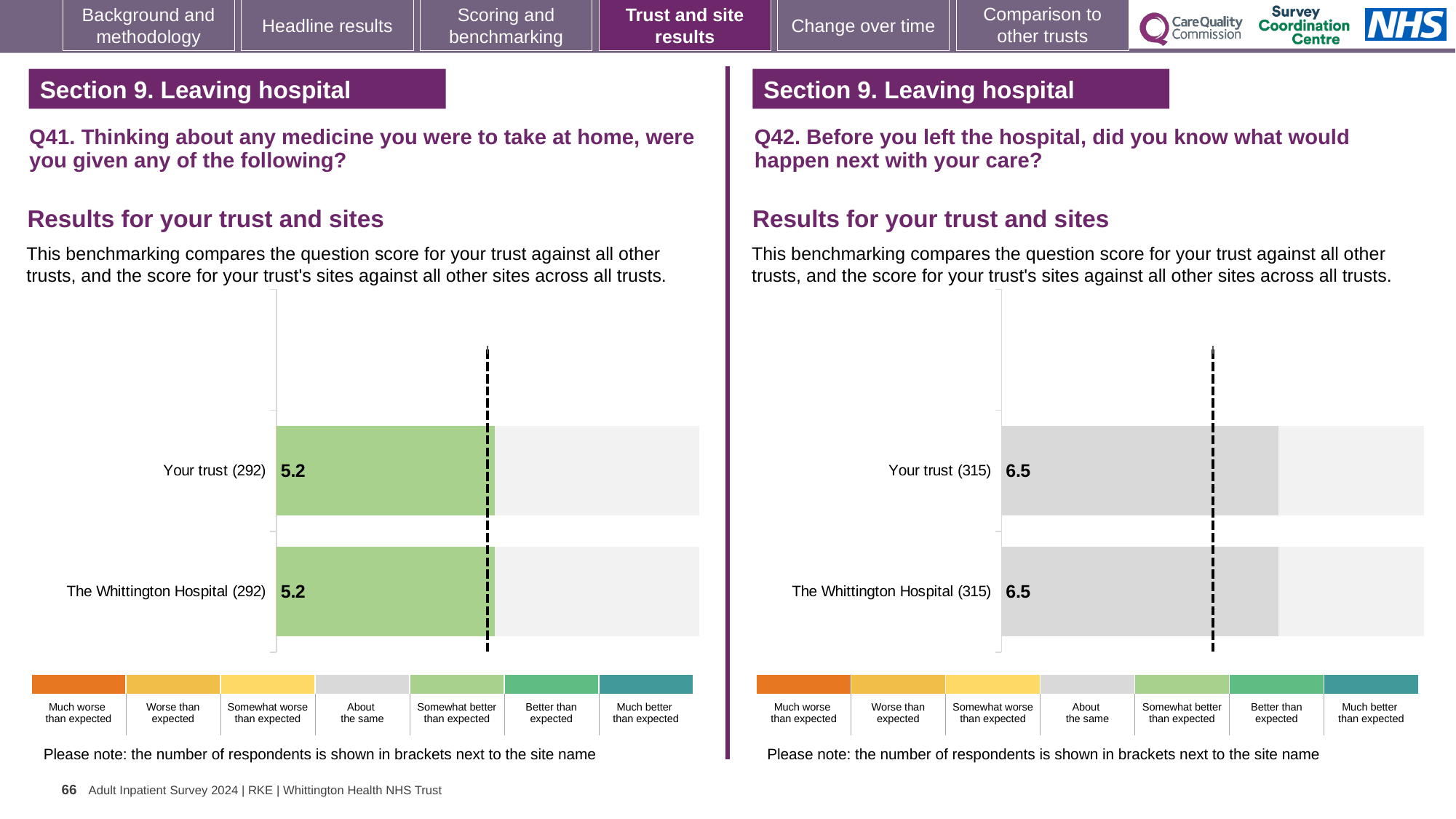
On the Q41 chart (left), what is the difference between the score for Your trust and the score for The Whittington Hospital? 0 What kind of chart is used on the Q41 chart (left)? Bar chart On the Q42 chart (right), which benchmark category does the colour of the bars correspond to? About the same On the Q42 chart (right), how many bars are plotted? 2 On the Q41 chart (left), which benchmark category does the colour of the bars correspond to? Somewhat better than expected On the Q41 chart (left), how many bars are plotted? 2 Is the score for Your trust on the Q42 chart (right) larger or smaller than the score for Your trust on the Q41 chart (left)? Larger On the Q42 chart (right), what is the score for The Whittington Hospital (315)? 6.5 On the Q42 chart (right), what is the score for Your trust (315)? 6.5 On the Q42 chart (right), what is the difference between the score for Your trust and the score for The Whittington Hospital? 0 On the Q41 chart (left), what is the score for Your trust (292)? 5.2 On the Q41 chart (left), what is the score for The Whittington Hospital (292)? 5.2